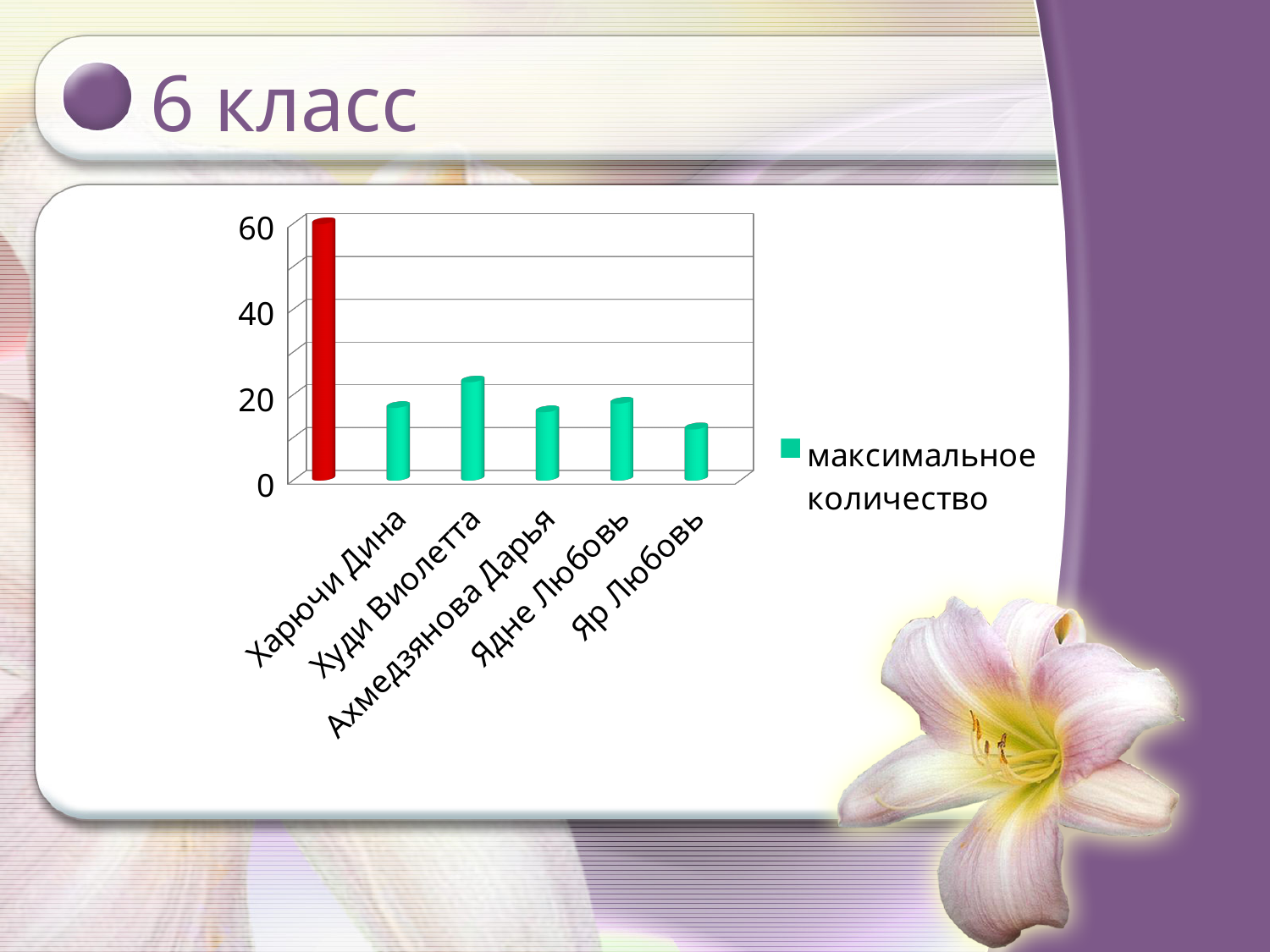
Which is larger, the value for Ядне Любовь or the value for Яр Любовь? Ядне Любовь Among the named students, who has the lowest bar? Яр Любовь How many series does the legend list? 1 Among the named students, who has the highest bar? Худи Виолетта How many bars are plotted in the chart? 6 What colour is the first (tallest) bar in the chart? red Is the value for Яр Любовь greater or less than 20? less Which is larger, the value for Худи Виолетта or the value for Ахмедзянова Дарья? Худи Виолетта What is the legend entry of the chart? максимальное количество What kind of chart is shown on the slide? bar chart What value does the red bar reach on the vertical axis? 60 Is the value for Худи Виолетта greater or less than 20? greater